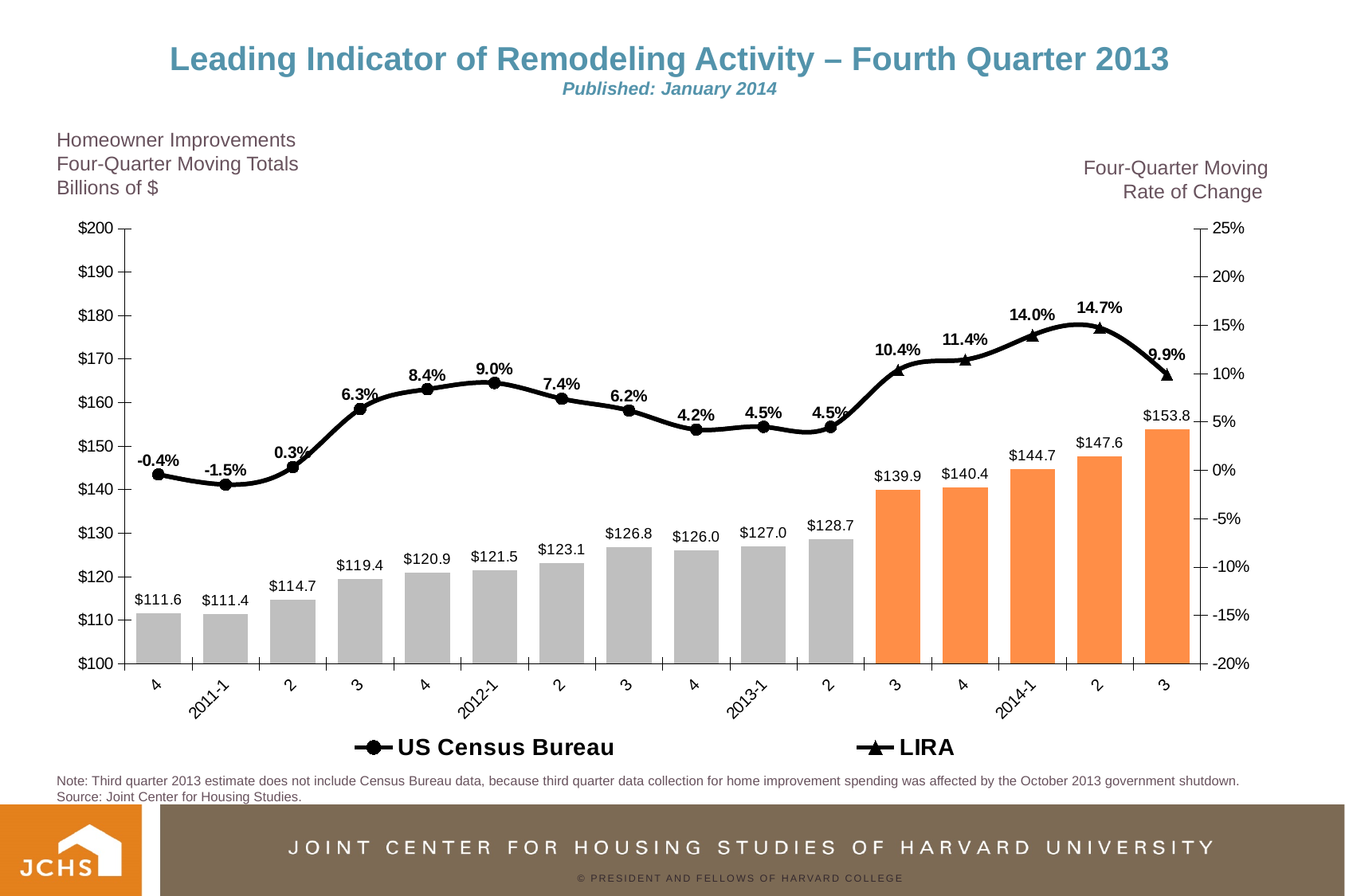
What is the four-quarter moving rate of change shown for 2012-1? 9.0% Which quarter has the highest four-quarter moving total bar? 2014-3 ($153.8) Which quarter has the lowest four-quarter moving rate of change? 2011-1 (-1.5%) Do the four-quarter moving total bars generally rise or fall from left to right? Rise What kind of chart is shown on the slide? Combined bar and line chart What is the four-quarter moving total for 2014-1? $144.7 Which is larger, the four-quarter moving total for 2012-4 or for 2013-1? 2013-1 ($127.0) How many quarterly bars are plotted on the chart? 16 Which quarter has the highest four-quarter moving rate of change? 2014-2 (14.7%) How many series does the legend list? 2 What are the two series named in the legend? US Census Bureau and LIRA What is the difference between the four-quarter moving totals for 2014-3 and 2014-2? $6.2